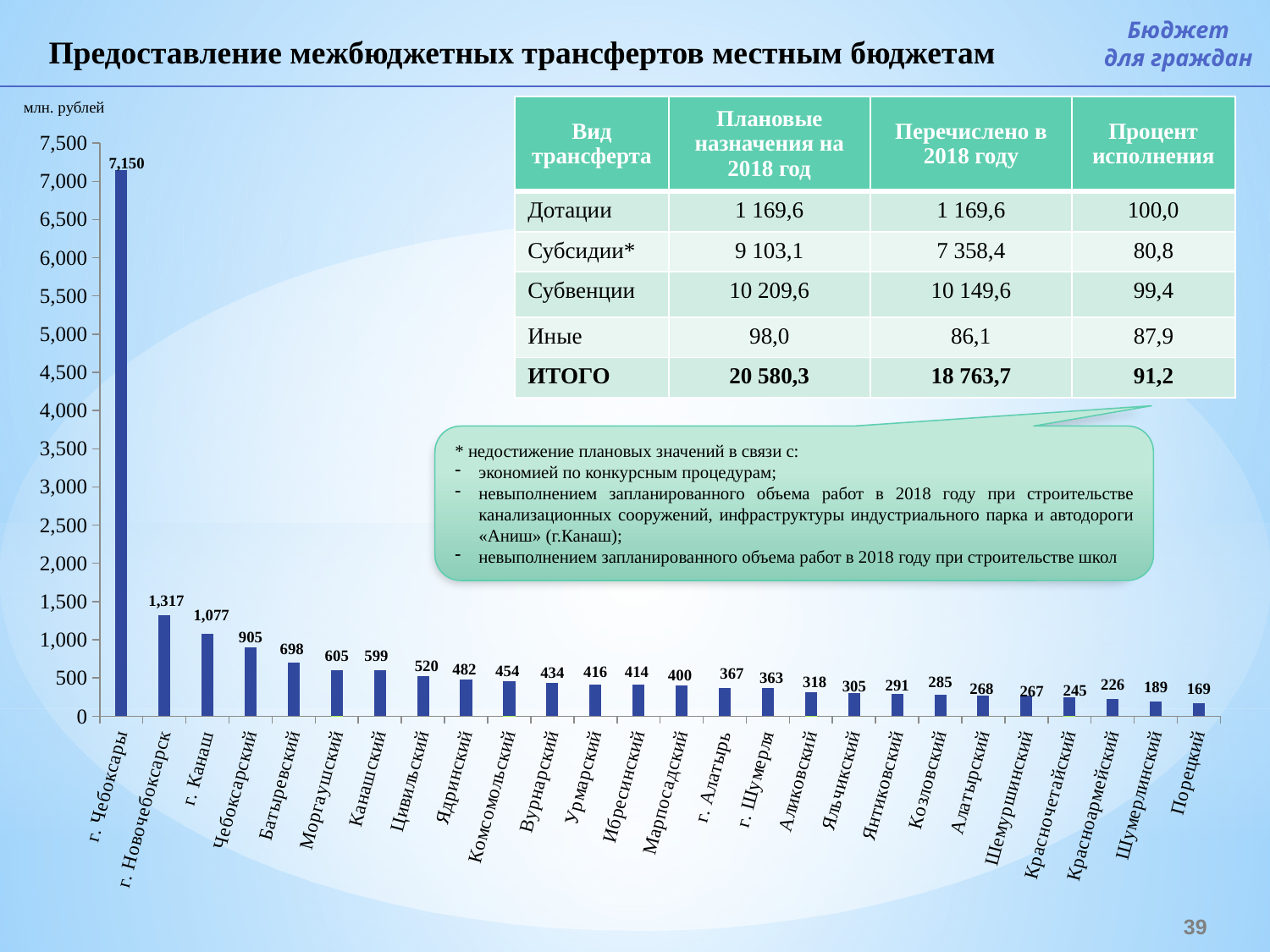
What is the difference between the values for г. Новочебоксарск and г. Канаш? 240 What is the value for Марпосадский? 400 Which category has the highest value? г. Чебоксары What is the value for Красночетайский? 245 What is the value for Батыревский? 698 Is the value for Чебоксарский greater or less than 1,000? less Which category has the lowest value? Порецкий How many categories are shown on the chart? 26 What is the value for г. Чебоксары? 7,150 Do the values rise or fall from left to right along the x axis? fall What kind of chart is shown on the slide? bar chart Which is larger, the value for Цивильский or the value for Ядринский? Цивильский